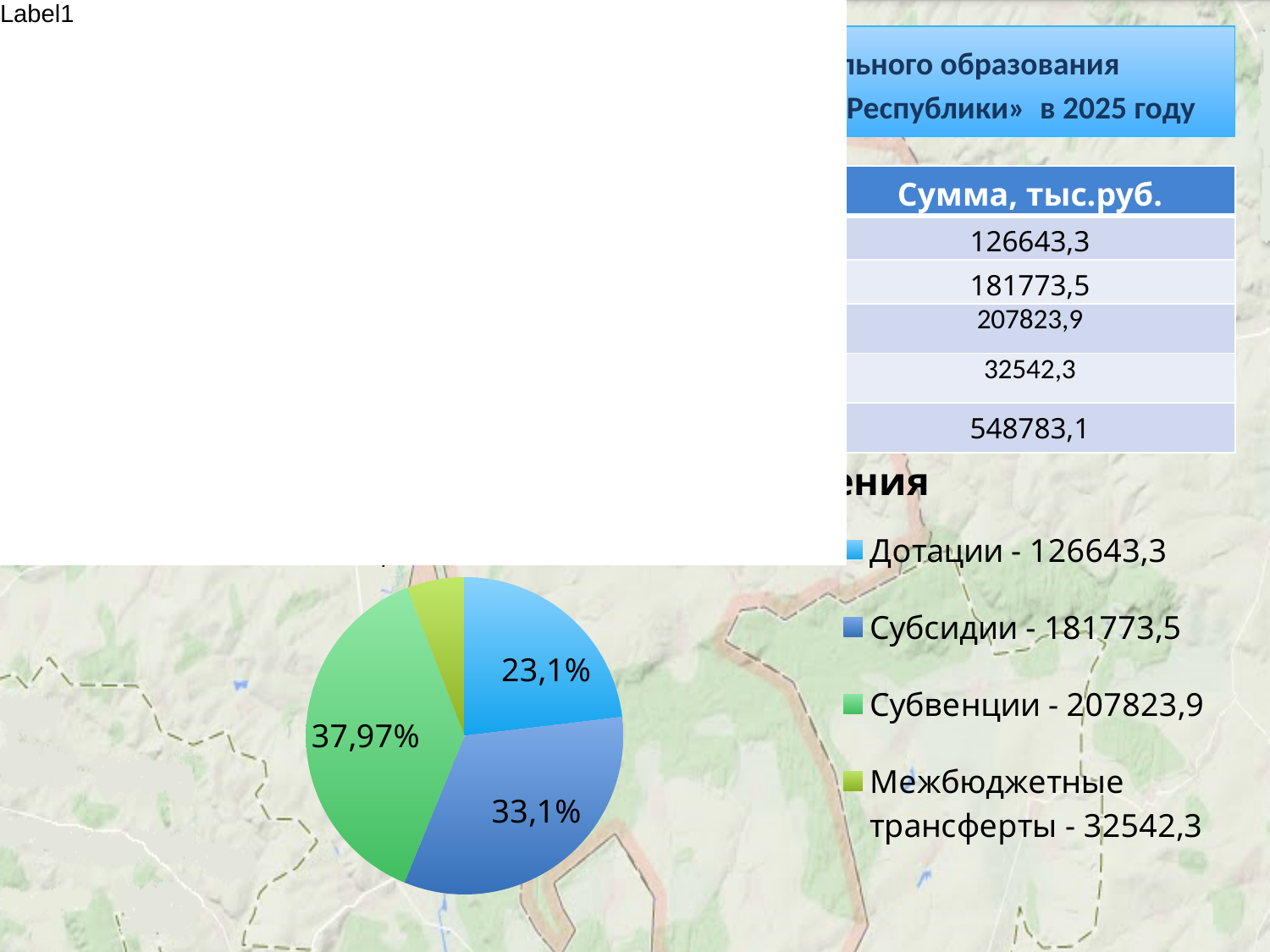
Which category has the smallest slice of the pie? Межбюджетные трансферты What value does the legend give for Межбюджетные трансферты? 32542,3 What share of the pie does Дотации represent? 23,1% What is the difference in percentage points between the Субсидии slice and the Дотации slice? 10% How many slices does the pie chart have? 4 Which slice is larger, Субсидии or Дотации? Субсидии Which category has the largest slice of the pie? Субвенции What colour is the Субвенции slice in the pie chart? green What value does the legend give for Субвенции? 207823,9 What share of the pie does Субсидии represent? 33,1% What kind of chart is shown on the slide? pie chart What share of the pie does Субвенции represent? 37,97%